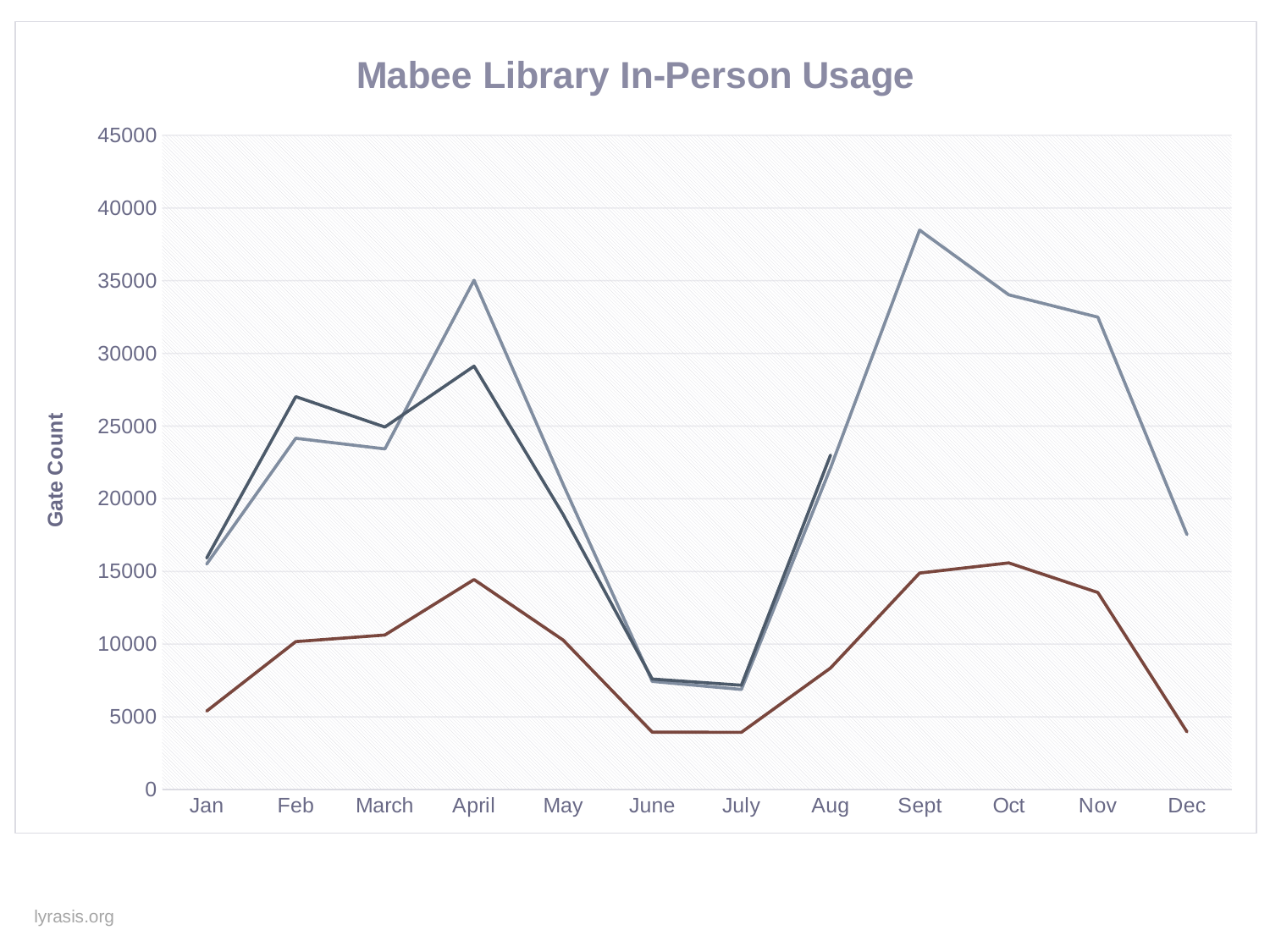
Is the value of the dark blue-gray line in April greater or less than 25000? greater Is the value of the brown line in June greater or less than 5000? less Is the value of the light gray-blue line in Dec greater or less than 20000? less What is the title of the chart? Mabee Library In-Person Usage In April, which line is higher: the light gray-blue line or the dark blue-gray line? the light gray-blue line What is the label on the vertical axis of the chart? Gate Count How many months are shown along the x axis of the chart? 12 Does the brown line rise or fall from Oct to Dec? fall How many lines are plotted on the chart? 3 In which month does the light gray-blue line reach its highest value? Sept What kind of chart is shown on the slide? line chart